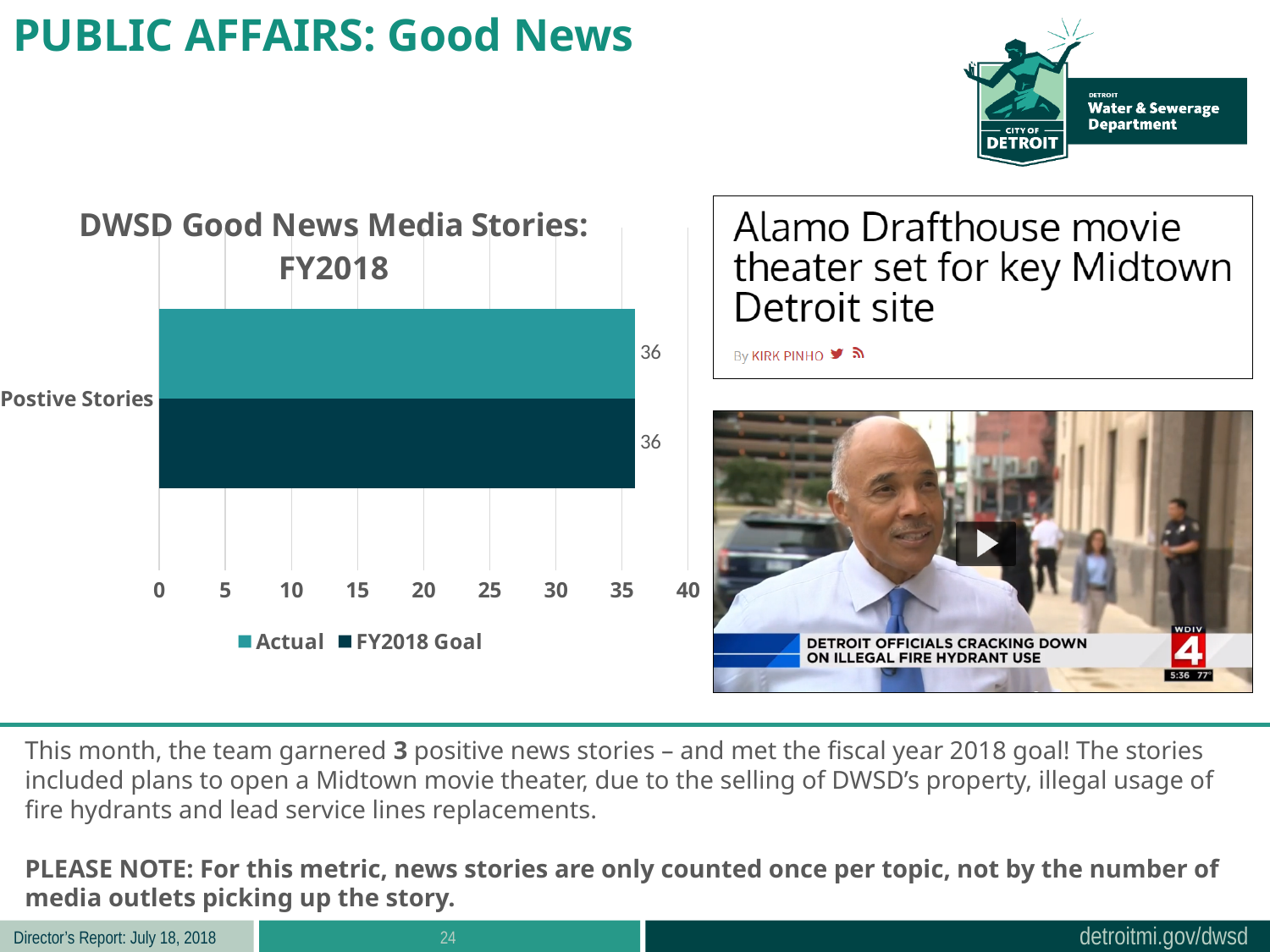
What is the maximum value shown on the x axis? 40 What is the title of the chart? DWSD Good News Media Stories: FY2018 Is the Actual value for Postive Stories greater or less than 30? greater How many categories are shown on the chart? 1 What is the Actual value for Postive Stories? 36 What are the two series named in the legend? Actual and FY2018 Goal How many series does the legend list? 2 What is the difference between the Actual value and the FY2018 Goal value for Postive Stories? 0 What is the FY2018 Goal value for Postive Stories? 36 What kind of chart is shown? bar chart Is the FY2018 Goal value for Postive Stories greater or less than 40? less